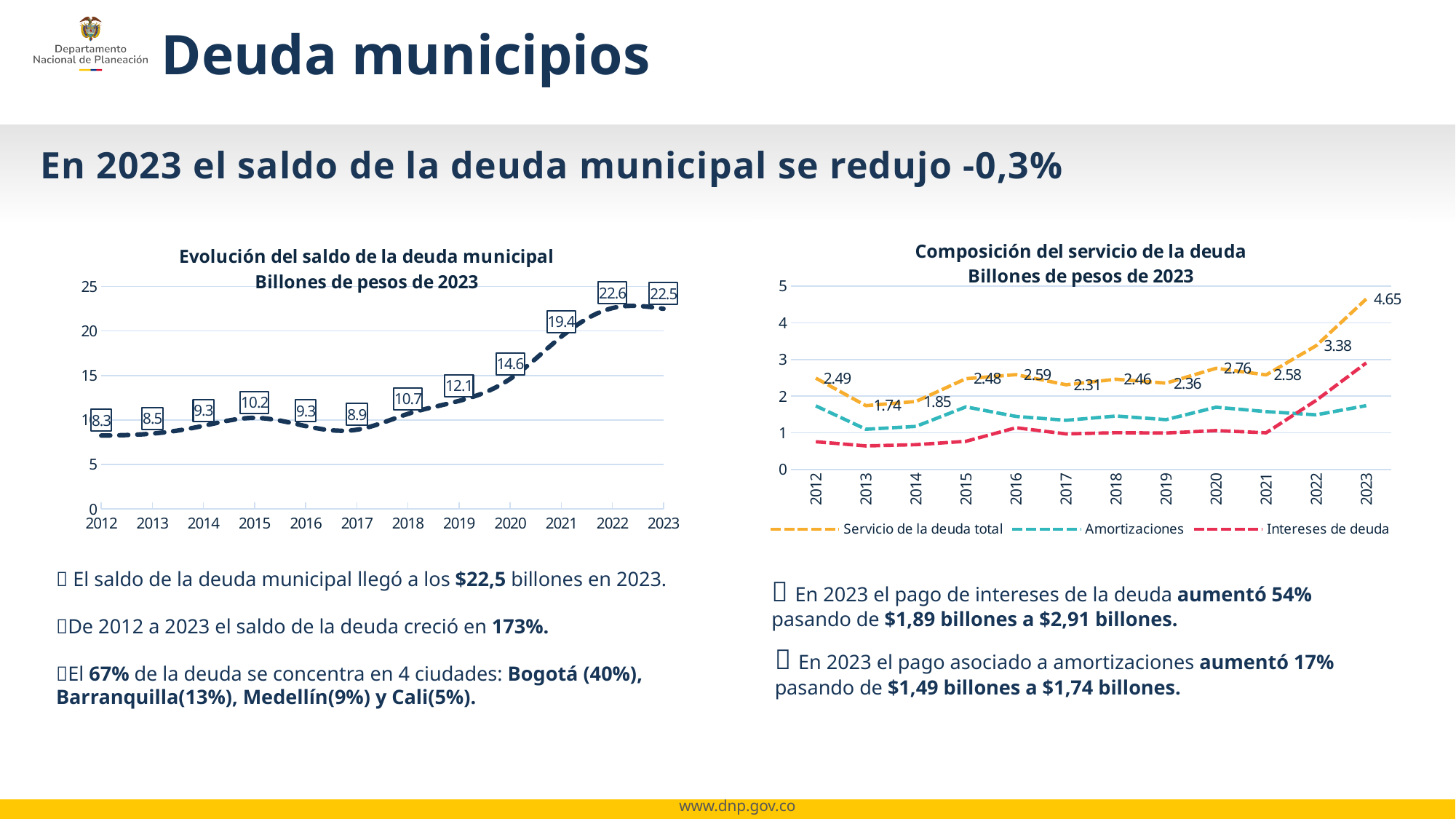
In the chart 'Composición del servicio de la deuda', what is the value of 'Servicio de la deuda total' for 2013? 1.74 In the chart 'Evolución del saldo de la deuda municipal', what is the value for 2023? 22.5 In the chart 'Evolución del saldo de la deuda municipal', how many years are plotted on the x axis? 12 In the chart 'Evolución del saldo de la deuda municipal', what is the value for 2012? 8.3 What kind of chart is 'Composición del servicio de la deuda'? Line chart In the chart 'Evolución del saldo de la deuda municipal', which year has the lowest value? 2012 In the chart 'Evolución del saldo de la deuda municipal', which year has the highest value? 2022 In the chart 'Composición del servicio de la deuda', what is the value of 'Servicio de la deuda total' for 2023? 4.65 In the chart 'Composición del servicio de la deuda', how many series does the legend list? 3 In the chart 'Evolución del saldo de la deuda municipal', what is the difference between the values for 2021 and 2020? 4.8 In the chart 'Composición del servicio de la deuda', which is larger for 2023: 'Amortizaciones' or 'Intereses de deuda'? Intereses de deuda In the chart 'Composición del servicio de la deuda', is the value of 'Intereses de deuda' for 2012 greater or less than 1? less